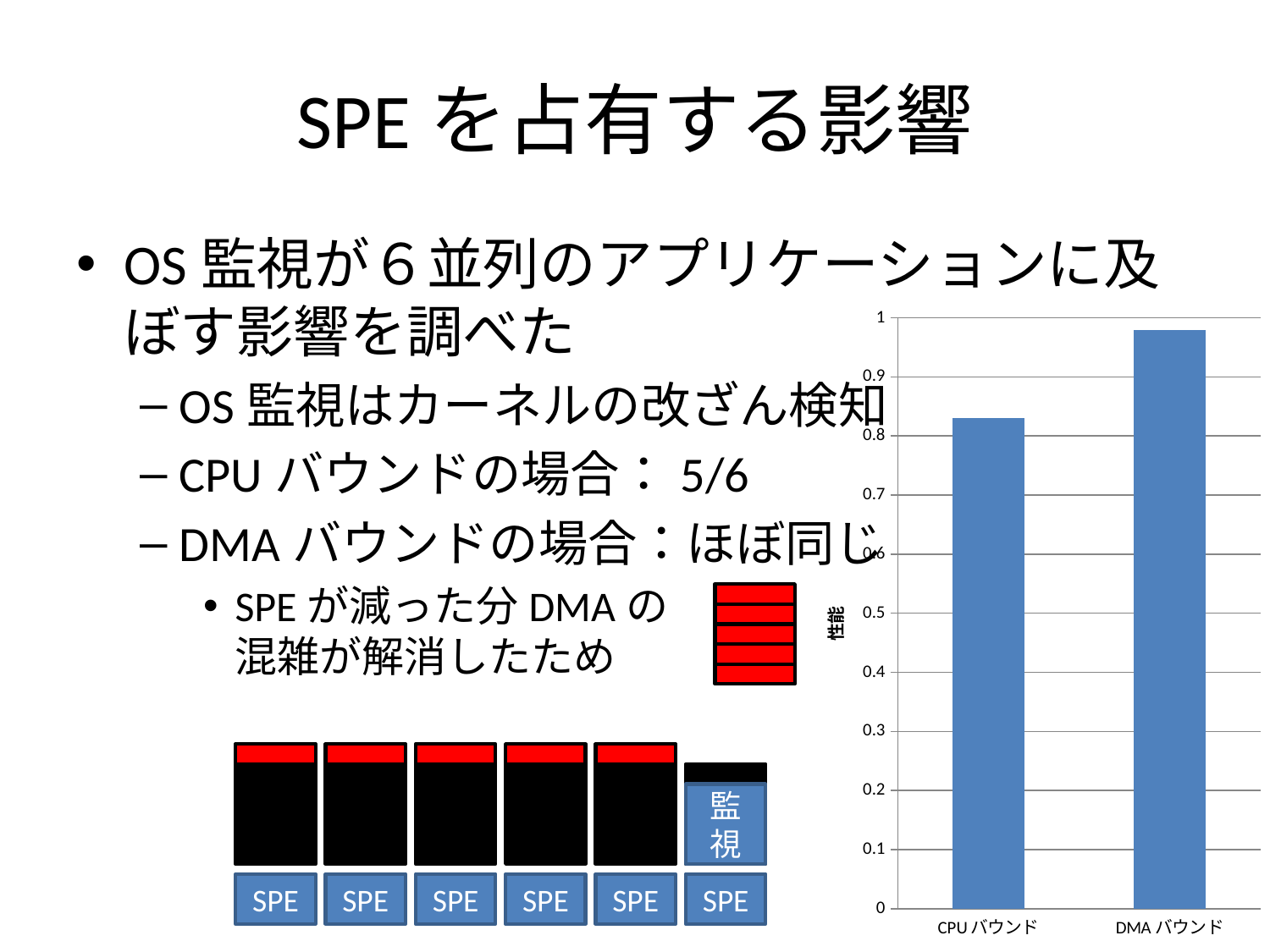
Is the value for CPU バウンド greater or less than 0.7? greater What kind of chart is shown on the slide? bar chart Is the value for DMA バウンド greater or less than 0.9? greater What is the label on the vertical axis of the chart? 性能 Is the value for CPU バウンド greater or less than 0.9? less Which is larger, the value for CPU バウンド or the value for DMA バウンド? DMA バウンド Do the values rise or fall going from CPU バウンド to DMA バウンド along the x axis? rise Which category has the highest value in the chart? DMA バウンド What is the highest tick value shown on the vertical axis of the chart? 1 Which category has the lowest value in the chart? CPU バウンド How many categories are plotted on the x axis of the chart? 2